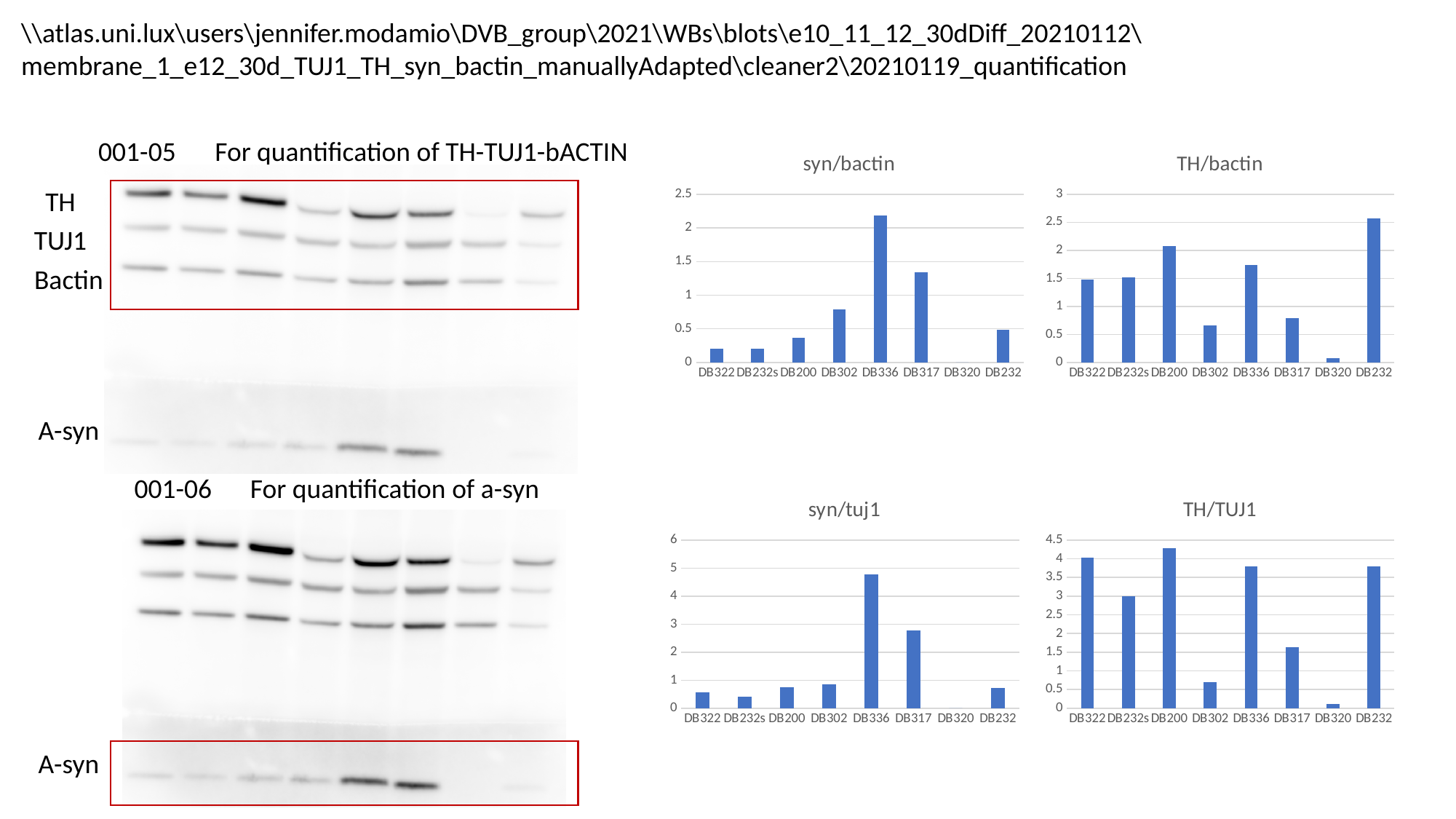
In the TH/TUJ1 chart, which category has the lowest value? DB320 What kind of chart is the syn/bactin chart? bar chart In the TH/bactin chart, which category has the lowest value? DB320 How many categories are shown on the x axis of the TH/TUJ1 chart? 8 In the TH/TUJ1 chart, is the value for DB302 greater or less than 1? less In the syn/tuj1 chart, which is larger, the value for DB317 or the value for DB302? DB317 In the TH/bactin chart, which is larger, the value for DB200 or the value for DB336? DB200 In the TH/bactin chart, which category has the highest value? DB232 In the syn/bactin chart, which category has the highest value? DB336 In the syn/tuj1 chart, which category has the highest value? DB336 In the syn/bactin chart, is the value for DB336 greater or less than 2? greater In the syn/tuj1 chart, is the value for DB336 greater or less than 4? greater